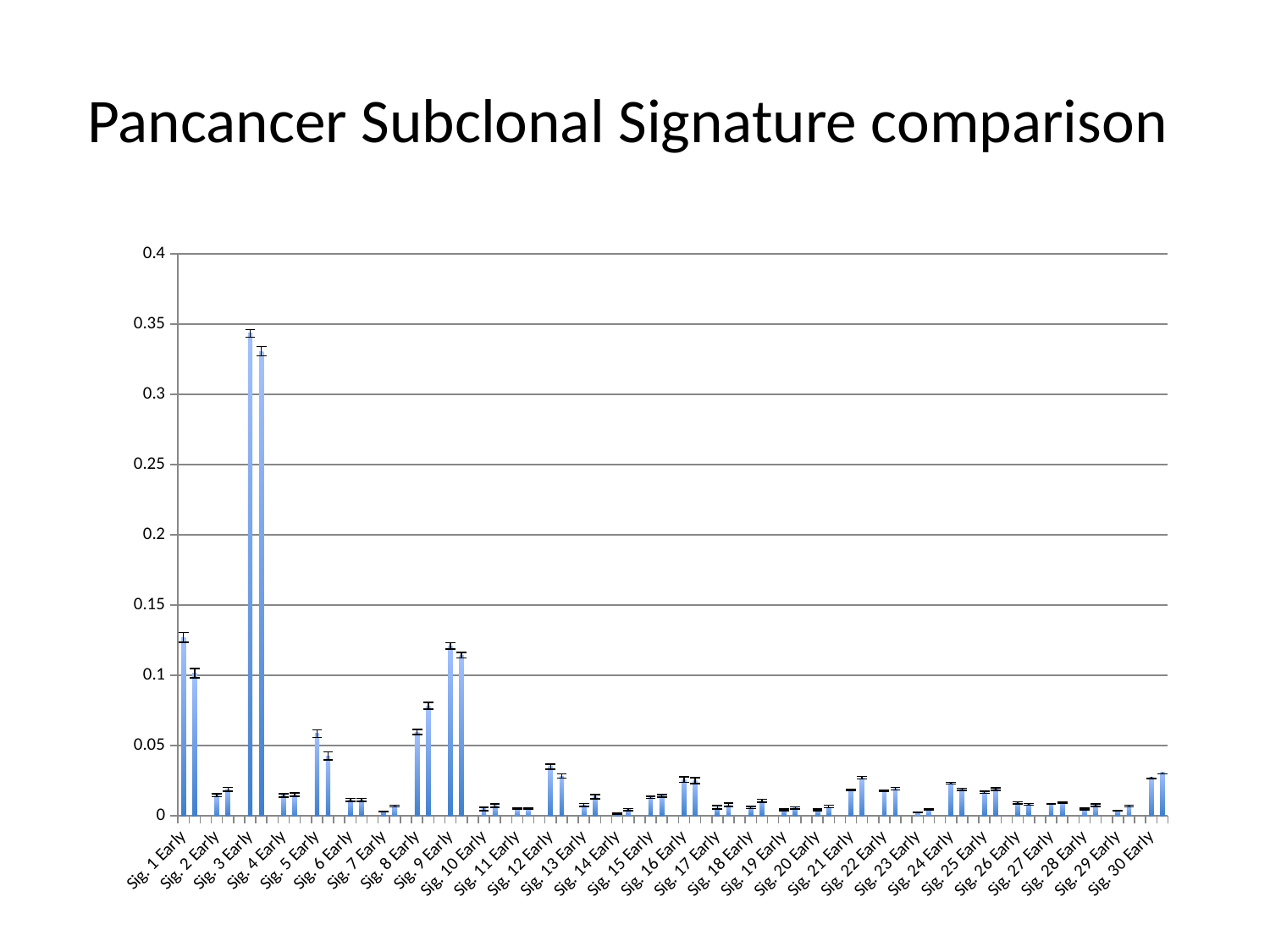
Is the value of the first bar for Sig. 9 Early greater or less than 0.1? greater What kind of chart is shown on the slide? bar chart Is the value of the first bar for Sig. 12 Early greater or less than 0.05? less Which has the larger first bar, Sig. 3 Early or Sig. 9 Early? Sig. 3 Early What is the title of the slide? Pancancer Subclonal Signature comparison Which has the larger first bar, Sig. 1 Early or Sig. 5 Early? Sig. 1 Early What is the highest value shown on the y axis? 0.4 Is the value of the first bar for Sig. 3 Early greater or less than 0.3? greater Which signature category has the tallest bars? Sig. 3 Early How many signature categories are labeled along the x axis? 30